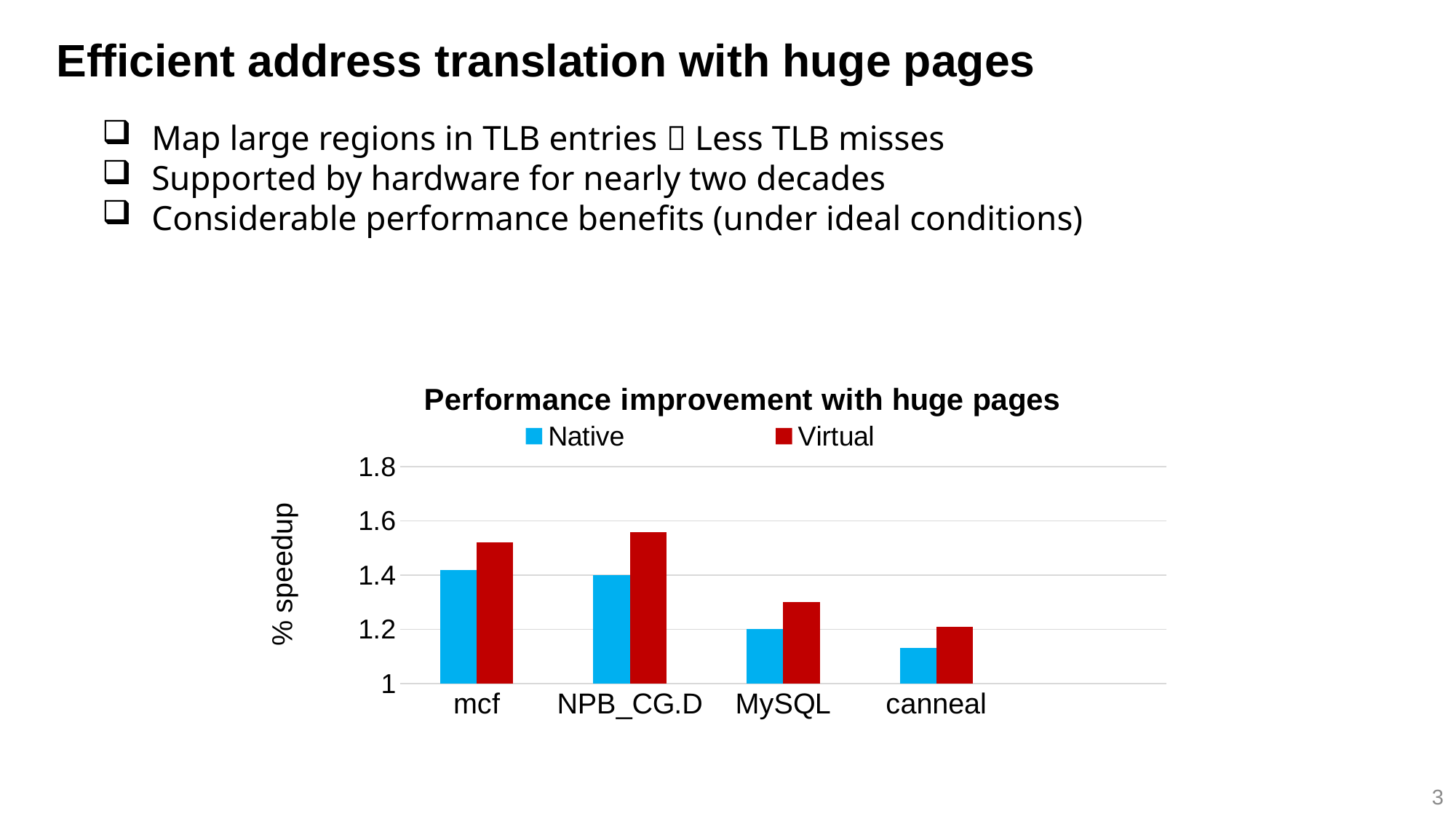
Is the Virtual value for mcf greater or less than 1.4? greater For canneal, which is larger, the Native value or the Virtual value? Virtual What is the label on the y axis of the chart? % speedup How many categories are shown on the x axis of the chart? 4 How many series does the legend list in the chart? 2 What is the title of the chart? Performance improvement with huge pages Is the Native value for canneal greater or less than 1.2? less What kind of chart is shown on the slide? bar chart For mcf, which is larger, the Native value or the Virtual value? Virtual Which category has the lowest Virtual value? canneal Which category has the lowest Native value? canneal